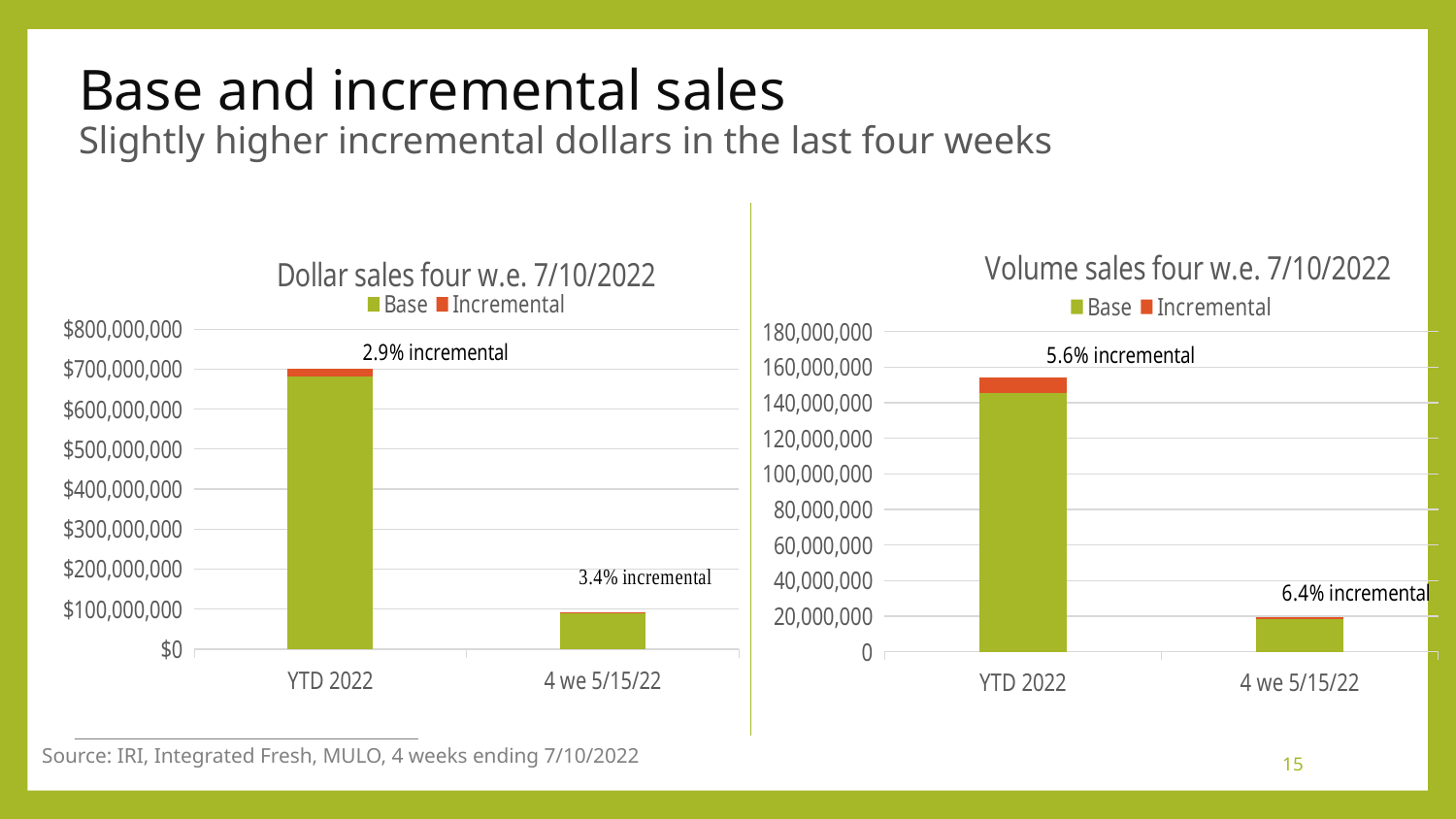
In the Volume sales four w.e. 7/10/2022 chart, is the total bar for 4 we 5/15/22 greater or less than 40,000,000? less In the Dollar sales four w.e. 7/10/2022 chart, is the total bar for YTD 2022 greater or less than $600,000,000? greater In the Dollar sales four w.e. 7/10/2022 chart, which category has the taller bar, YTD 2022 or 4 we 5/15/22? YTD 2022 In the Dollar sales four w.e. 7/10/2022 chart, what incremental percentage is labelled for YTD 2022? 2.9% How many categories are shown on the x axis of the Dollar sales four w.e. 7/10/2022 chart? 2 In the Volume sales four w.e. 7/10/2022 chart, what incremental percentage is labelled for 4 we 5/15/22? 6.4% In the Volume sales four w.e. 7/10/2022 chart, is the total bar for YTD 2022 greater or less than 140,000,000? greater In the Volume sales four w.e. 7/10/2022 chart, what incremental percentage is labelled for YTD 2022? 5.6% What type of chart is the Volume sales four w.e. 7/10/2022 chart? Stacked bar chart In the Dollar sales four w.e. 7/10/2022 chart, what incremental percentage is labelled for 4 we 5/15/22? 3.4% How many series does the legend of the Volume sales four w.e. 7/10/2022 chart list? 2